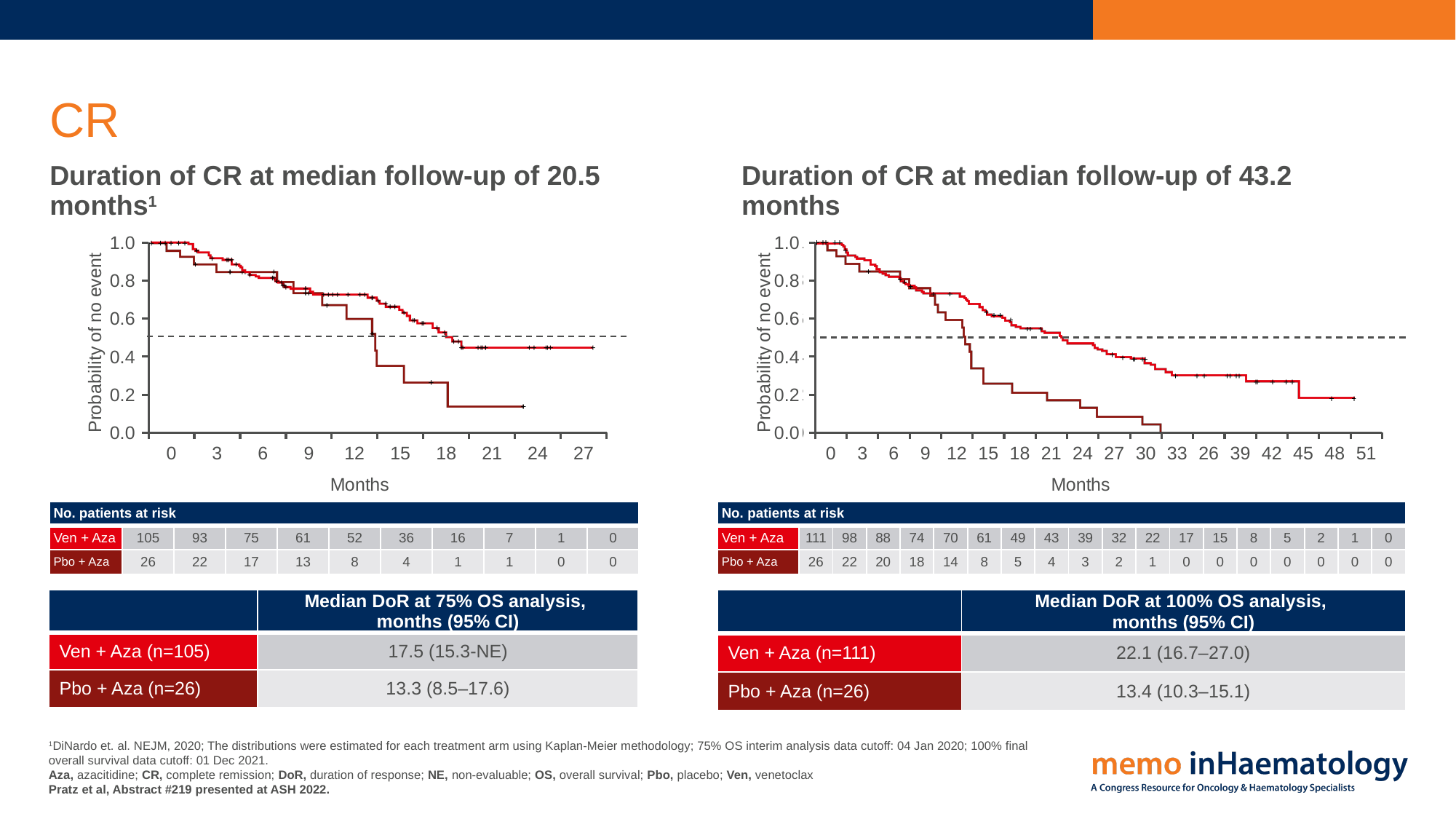
In the 'Duration of CR at median follow-up of 43.2 months' chart, is the Ven + Aza probability of no event at month 36 greater or less than 0.4? less In the 'Duration of CR at median follow-up of 20.5 months' chart, how many Pbo + Aza patients were at risk at month 12? 8 How many treatment arms are plotted in the 'Duration of CR at median follow-up of 43.2 months' chart? 2 For the 'Duration of CR at median follow-up of 43.2 months' chart, what is the median DoR (95% CI) for Pbo + Aza? 13.4 (10.3–15.1) In the 'Duration of CR at median follow-up of 20.5 months' chart, how many Ven + Aza patients were at risk at month 0? 105 In the 'Duration of CR at median follow-up of 43.2 months' chart, how many Pbo + Aza patients were at risk at month 9? 18 In the 'Duration of CR at median follow-up of 20.5 months' chart, which arm has the longer median DoR? Ven + Aza What kind of chart is shown under 'Duration of CR at median follow-up of 20.5 months'? line chart (Kaplan-Meier curve) For the 'Duration of CR at median follow-up of 20.5 months' chart, what is the median DoR (95% CI) for Ven + Aza? 17.5 (15.3-NE) For the 'Duration of CR at median follow-up of 43.2 months' chart, what is the difference in median DoR between Ven + Aza and Pbo + Aza in months? 8.7 In the 'Duration of CR at median follow-up of 20.5 months' chart, do the probability curves rise or fall as months increase? fall In the 'Duration of CR at median follow-up of 43.2 months' chart, how many Ven + Aza patients were at risk at month 0? 111